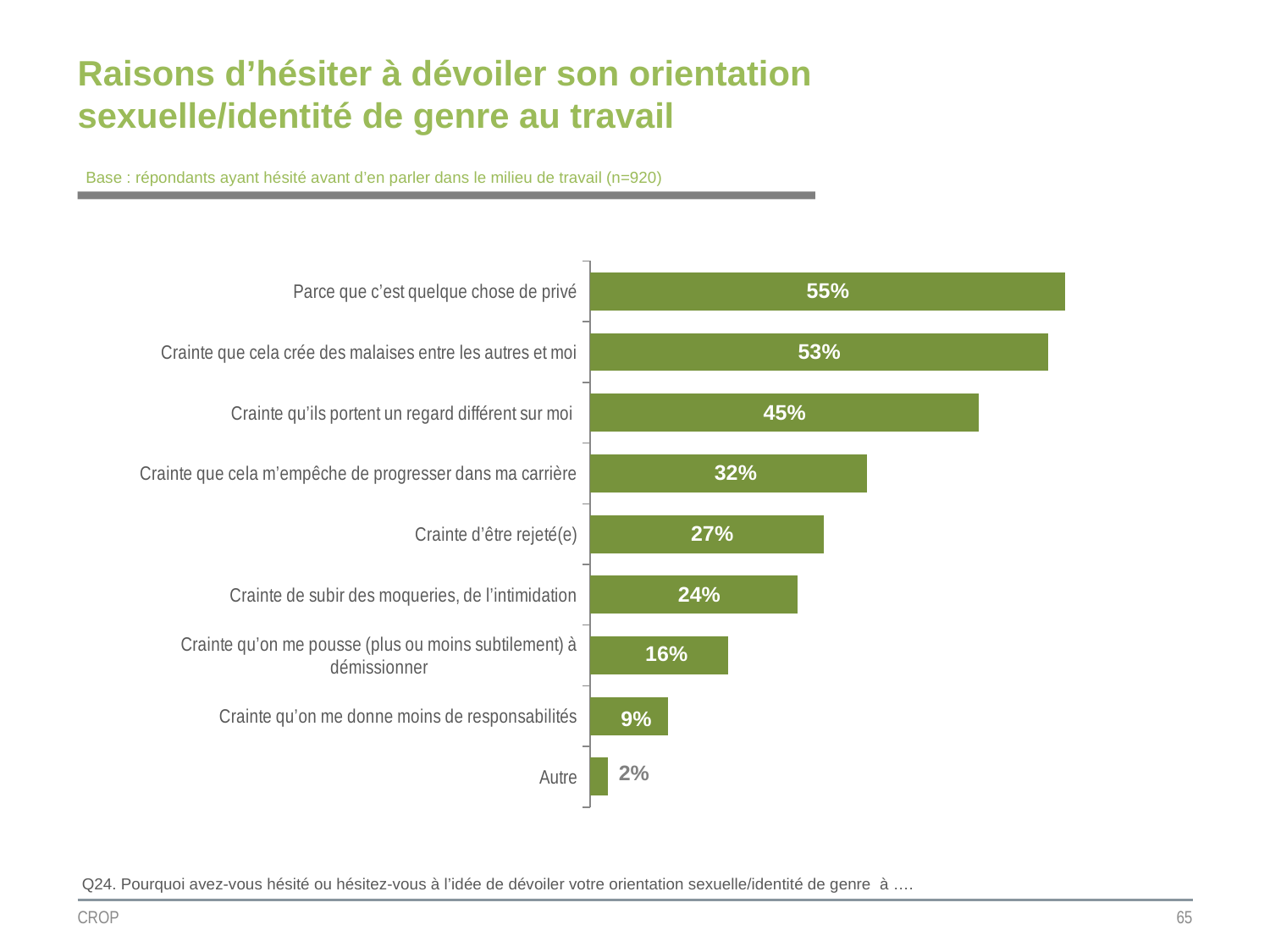
What is the difference between "Crainte qu'ils portent un regard différent sur moi" and "Crainte que cela m'empêche de progresser dans ma carrière"? 13% Which category has the lowest value? Autre What is the value for "Crainte qu'on me donne moins de responsabilités"? 9% What is the value for "Parce que c'est quelque chose de privé"? 55% What is the value for "Crainte que cela crée des malaises entre les autres et moi"? 53% Which category has the highest value? Parce que c'est quelque chose de privé How many categories are shown in the chart? 9 What is the value for "Crainte d'être rejeté(e)"? 27% What is the base (n) stated for the chart? n=920 What kind of chart is shown on the slide? Bar chart Which is larger: "Crainte de subir des moqueries, de l'intimidation" or "Crainte qu'on me pousse (plus ou moins subtilement) à démissionner"? Crainte de subir des moqueries, de l'intimidation What is the difference between the highest and lowest values in the chart? 53%